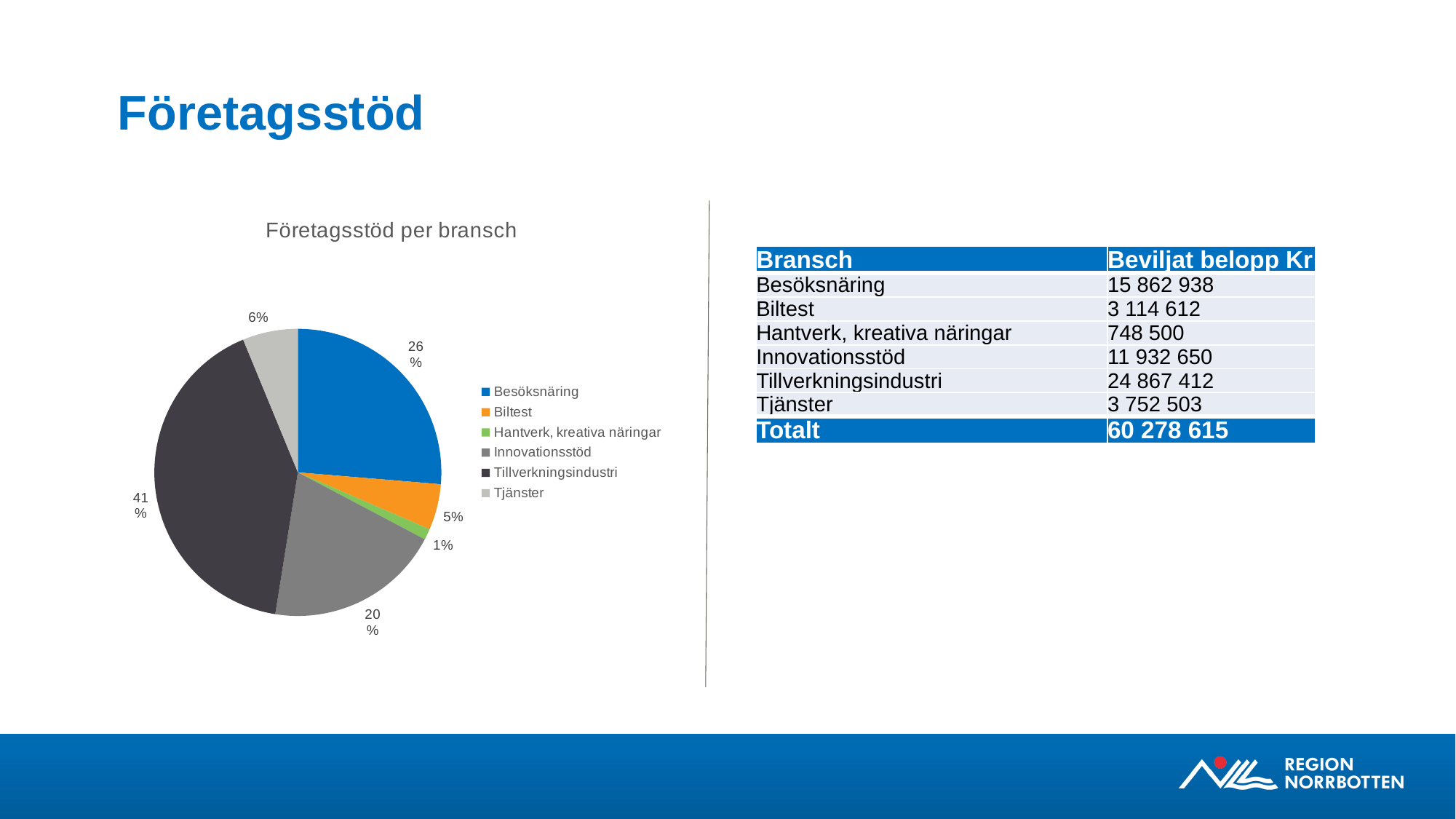
Which category has the smallest slice of the pie? Hantverk, kreativa näringar What share of the pie does Tjänster have? 6% Which slice is larger, Besöksnäring or Innovationsstöd? Besöksnäring What share of the pie does Innovationsstöd have? 20% Which category has the largest slice of the pie? Tillverkningsindustri What share of the pie does Besöksnäring have? 26% What is the title of the chart? Företagsstöd per bransch What type of chart is shown on the slide? pie chart How many slices does the pie chart have? 6 What is the difference in percentage points between the Tillverkningsindustri slice and the Besöksnäring slice? 15 percentage points